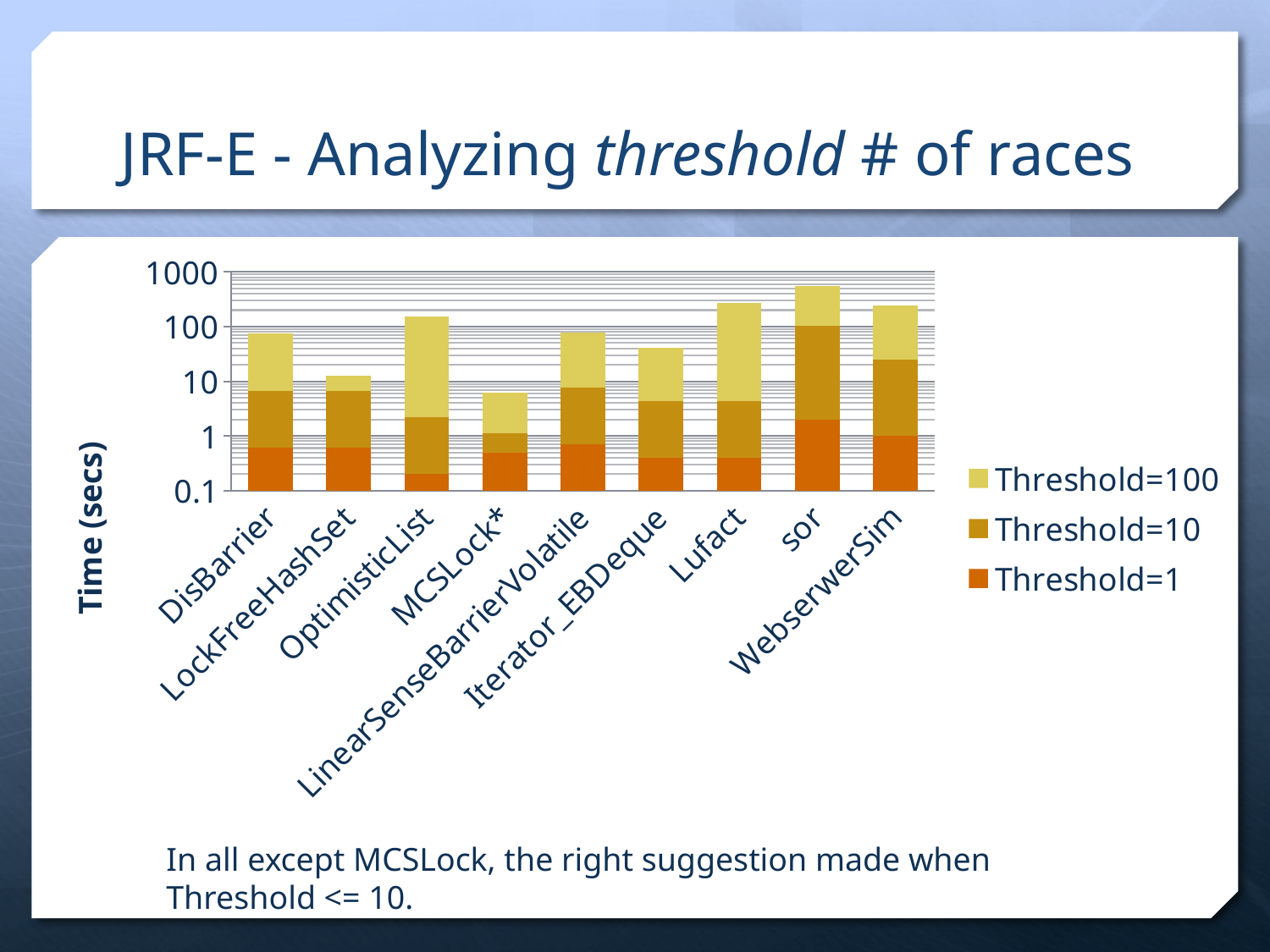
How many series does the chart's legend list? 3 Which category has the shortest stacked bar in the chart? MCSLock* Is the total bar height for Iterator_EBDeque greater or less than 100? less Which category has the tallest stacked bar in the chart? sor Is the total bar height for MCSLock* greater or less than 10? less What kind of chart is shown on the slide? Stacked bar chart Which has the taller stacked bar, Lufact or Iterator_EBDeque? Lufact What is the label of the y axis of the chart? Time (secs) How many benchmark categories are shown on the x axis of the chart? 9 Is the total bar height for sor greater or less than 100? greater Which legend entry is shown in the darkest orange colour? Threshold=1